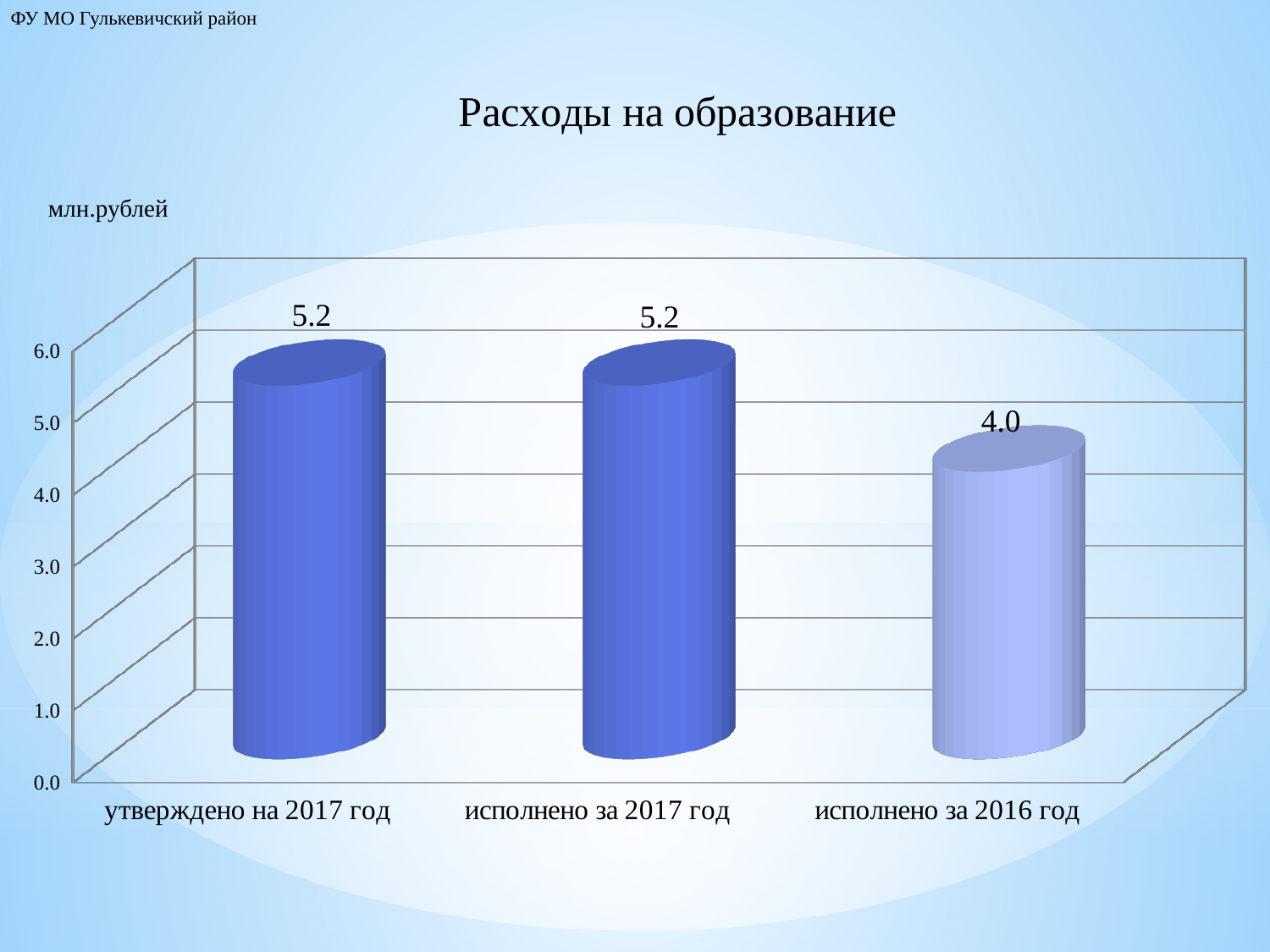
What kind of chart is shown on the slide? bar chart Is the value for "исполнено за 2016 год" greater or less than 5.0? less Is the value for "исполнено за 2017 год" greater or less than 5.0? greater Which category has the lowest value? исполнено за 2016 год What is the title of the chart? Расходы на образование What is the difference between the values for "исполнено за 2017 год" and "исполнено за 2016 год"? 1.2 How many categories are shown on the chart? 3 What is the value for "исполнено за 2017 год"? 5.2 What is the value for "исполнено за 2016 год"? 4.0 What is the value for "утверждено на 2017 год"? 5.2 Which is larger: the value for "утверждено на 2017 год" or the value for "исполнено за 2016 год"? утверждено на 2017 год What unit is indicated for the values on the chart? млн.рублей